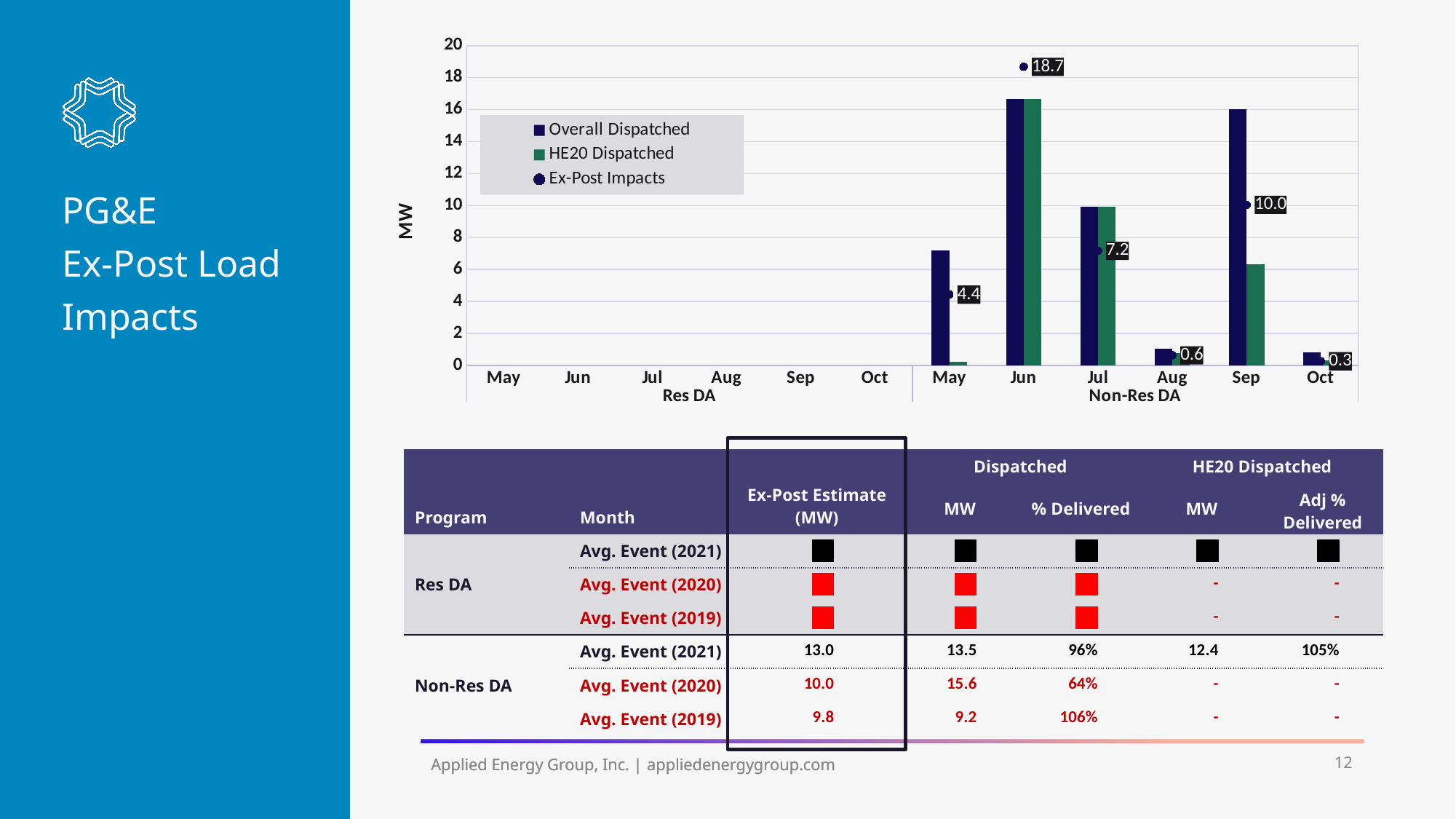
Which Non-Res DA month has the highest Ex-Post Impacts value? Jun What is the difference between the Ex-Post Impacts values for Non-Res DA in June and July? 11.5 Is the Overall Dispatched value for Non-Res DA in June greater or less than 16? greater What is the Ex-Post Impacts value for Non-Res DA in May? 4.4 Is the Ex-Post Impacts value for Non-Res DA in July larger or smaller than the value for Non-Res DA in September? smaller What is the Ex-Post Impacts value for Non-Res DA in October? 0.3 What is the Ex-Post Impacts value for Non-Res DA in September? 10.0 What is the label of the y axis of the chart? MW Is the HE20 Dispatched value for Non-Res DA in September greater or less than 8? less Which Non-Res DA month has the lowest Ex-Post Impacts value? Oct What is the Ex-Post Impacts value for Non-Res DA in June? 18.7 How many series does the chart legend list? 3